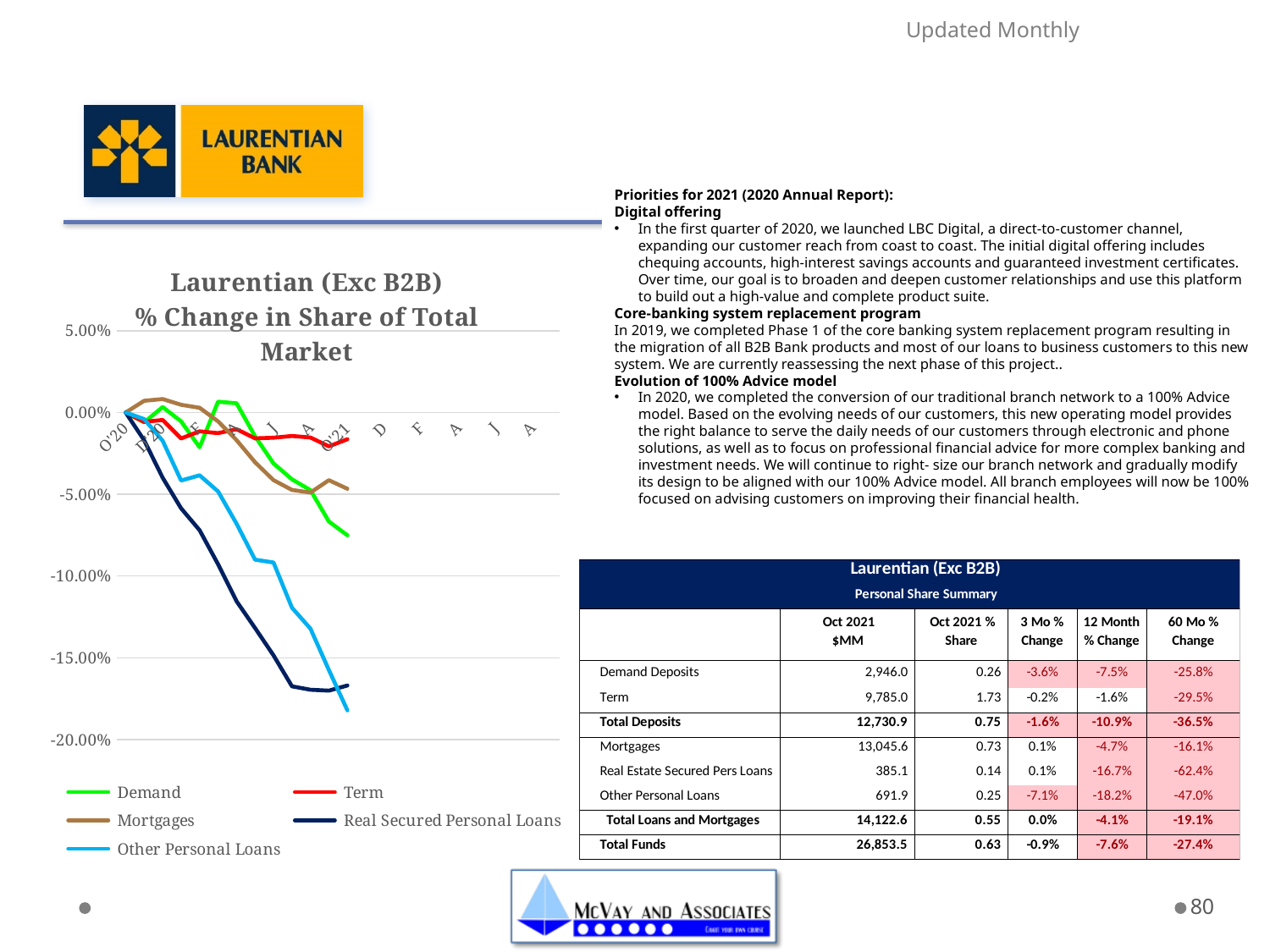
Does the Other Personal Loans line rise or fall across the chart? fall Is the value for Real Secured Personal Loans at O'21 greater or less than -15.00%? less What kind of chart is shown on the slide? line chart Is the value for Term at O'21 greater or less than -5.00%? greater What is the title of the chart? Laurentian (Exc B2B) % Change in Share of Total Market Which series stays closest to 0.00% across the whole chart? Term Is the value for Other Personal Loans at O'21 greater or less than -15.00%? less Does the Real Secured Personal Loans line rise or fall from O'20 to O'21? fall Which colour is used for the Demand series in the chart? green How many series does the chart legend list? 5 At O'21, which is higher: Demand or Real Secured Personal Loans? Demand